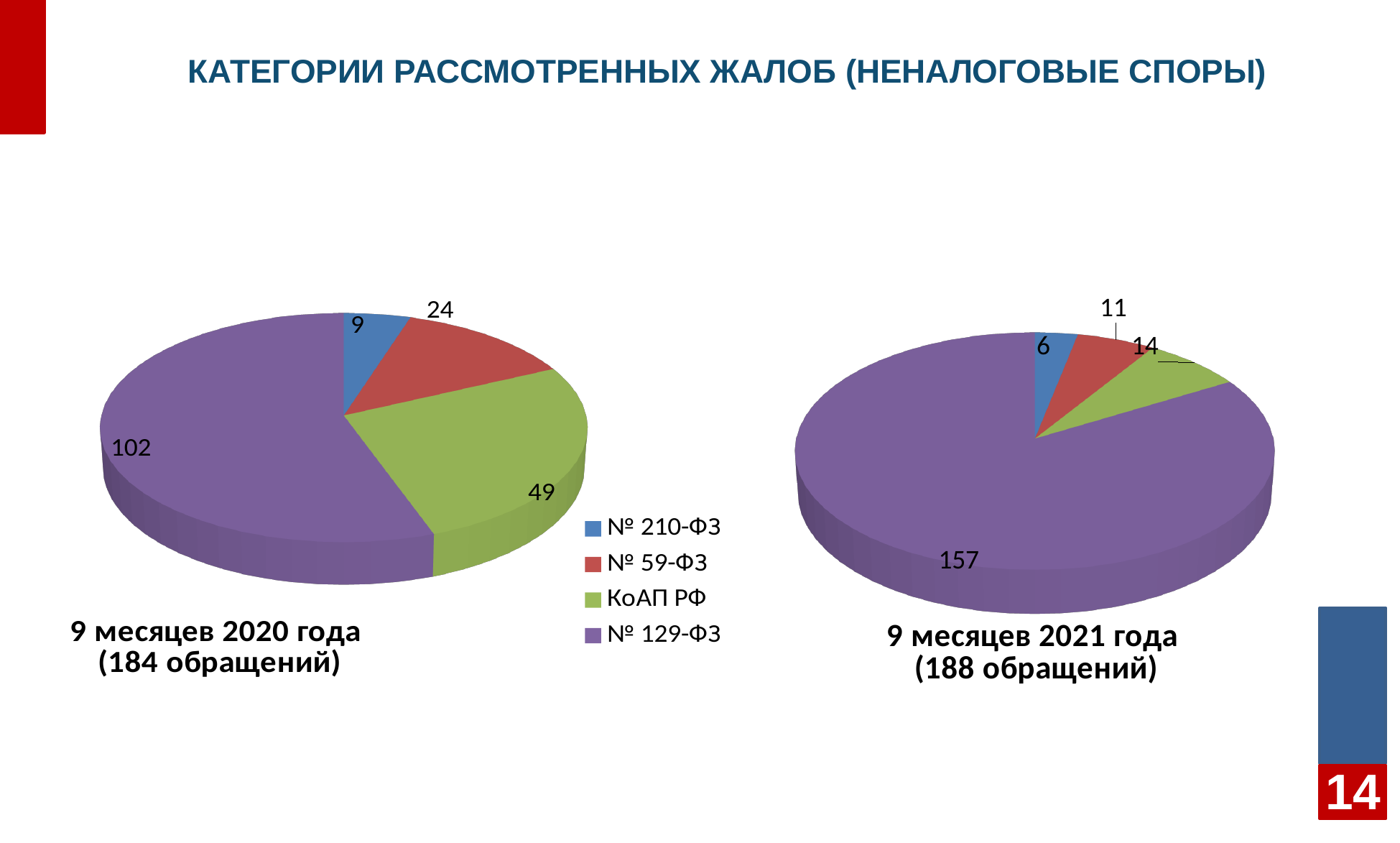
In the pie chart for 9 месяцев 2020 года, what is the difference between КоАП РФ and № 59-ФЗ? 25 How many categories does the legend list? 4 In the pie chart for 9 месяцев 2021 года, which category has the smallest slice? № 210-ФЗ In the pie chart for 9 месяцев 2020 года, which category has the largest slice? № 129-ФЗ Which colour represents № 59-ФЗ in the legend? Red Which is larger: КоАП РФ in the 2020 chart or КоАП РФ in the 2021 chart? КоАП РФ in the 2020 chart In the pie chart for 9 месяцев 2021 года, what is the value for № 129-ФЗ? 157 In the pie chart for 9 месяцев 2020 года, what is the value for № 59-ФЗ? 24 What type of chart is used on this slide? Pie chart In the pie chart for 9 месяцев 2020 года, what is the value for КоАП РФ? 49 What is the difference between the № 129-ФЗ values in the 2021 chart and the 2020 chart? 55 In the pie chart for 9 месяцев 2021 года, what is the value for № 210-ФЗ? 6